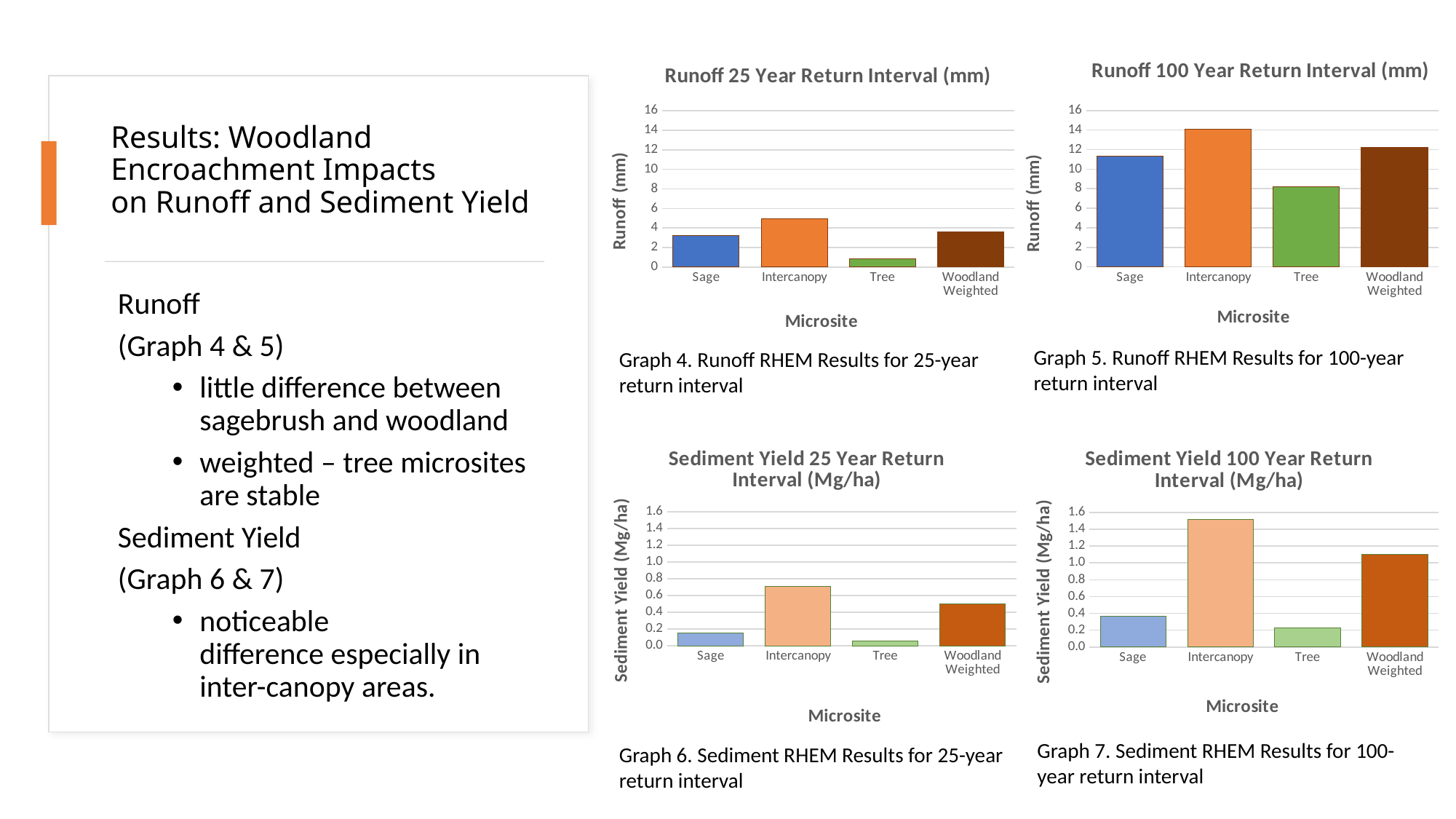
In the 'Runoff 25 Year Return Interval (mm)' chart, which microsite has the highest runoff? Intercanopy In the 'Sediment Yield 100 Year Return Interval (Mg/ha)' chart, is the value for Intercanopy greater or less than 1.2? greater In the 'Runoff 100 Year Return Interval (mm)' chart, which microsite has the lowest runoff? Tree In the 'Sediment Yield 25 Year Return Interval (Mg/ha)' chart, which microsite has the highest sediment yield? Intercanopy What kind of chart is the 'Runoff 100 Year Return Interval (mm)' chart? bar chart In the 'Sediment Yield 100 Year Return Interval (Mg/ha)' chart, which microsite has the lowest sediment yield? Tree In the 'Runoff 25 Year Return Interval (mm)' chart, which microsite has the lowest runoff? Tree In the 'Runoff 100 Year Return Interval (mm)' chart, is the value for Tree greater or less than 10? less How many microsite categories are shown in the 'Runoff 25 Year Return Interval (mm)' chart? 4 In the 'Sediment Yield 100 Year Return Interval (Mg/ha)' chart, which is larger, the value for Woodland Weighted or the value for Sage? Woodland Weighted In the 'Runoff 100 Year Return Interval (mm)' chart, is the value for Intercanopy greater or less than 12? greater